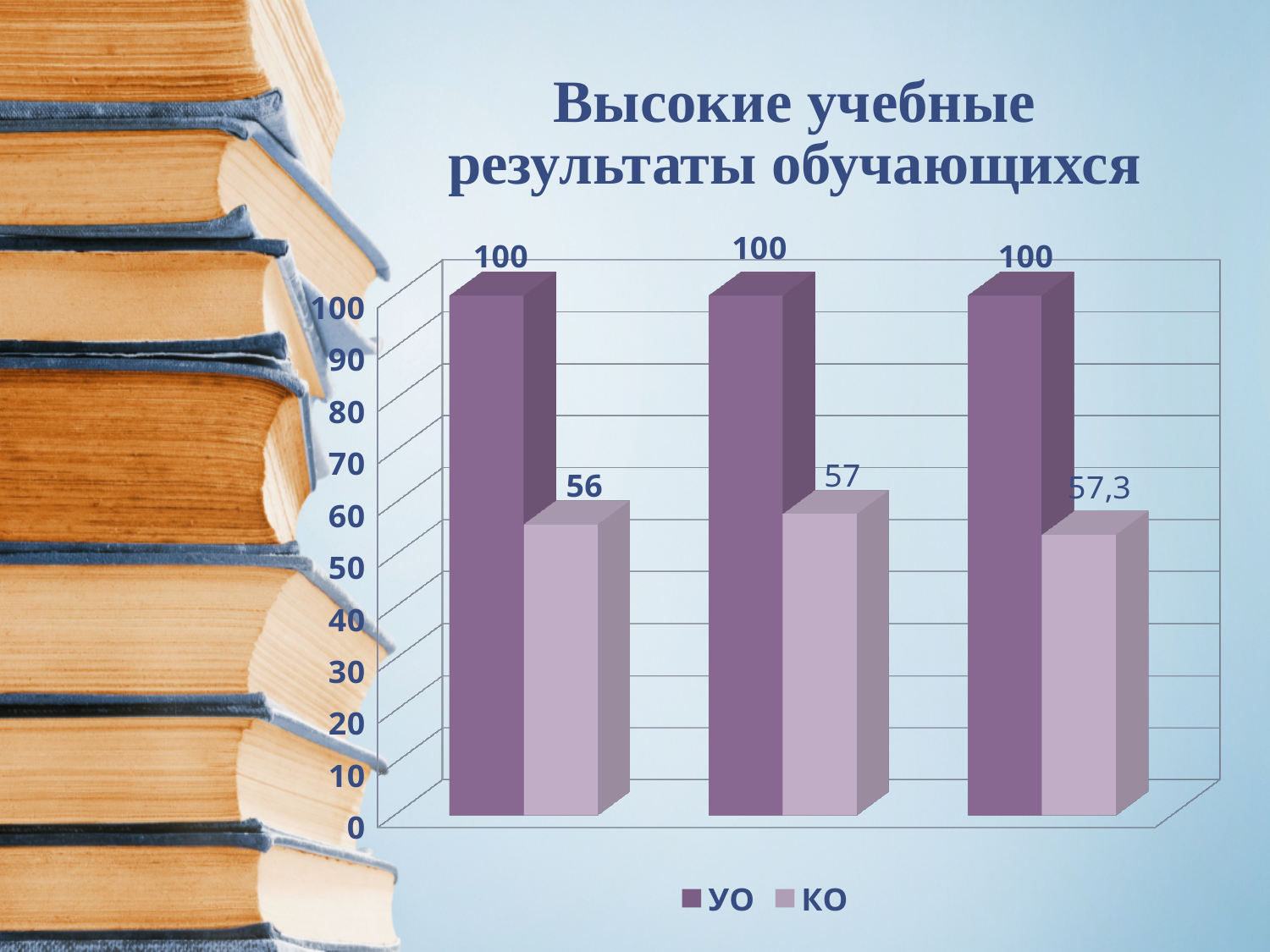
What is the value of the КО bar in the third (rightmost) group? 57,3 What is the value of the КО bar in the first (leftmost) group? 56 How many groups of bars are plotted in the chart? 3 What is the value of the УО bar in the middle group? 100 What is the difference between the УО and КО values in the first group? 44 What are the two series named in the legend? УО and КО How many series does the legend list? 2 What is the value of the КО bar in the second (middle) group? 57 What kind of chart is shown on the slide? bar chart Which series has the higher value in the first group, УО or КО? УО What is the title of the chart? Высокие учебные результаты обучающихся